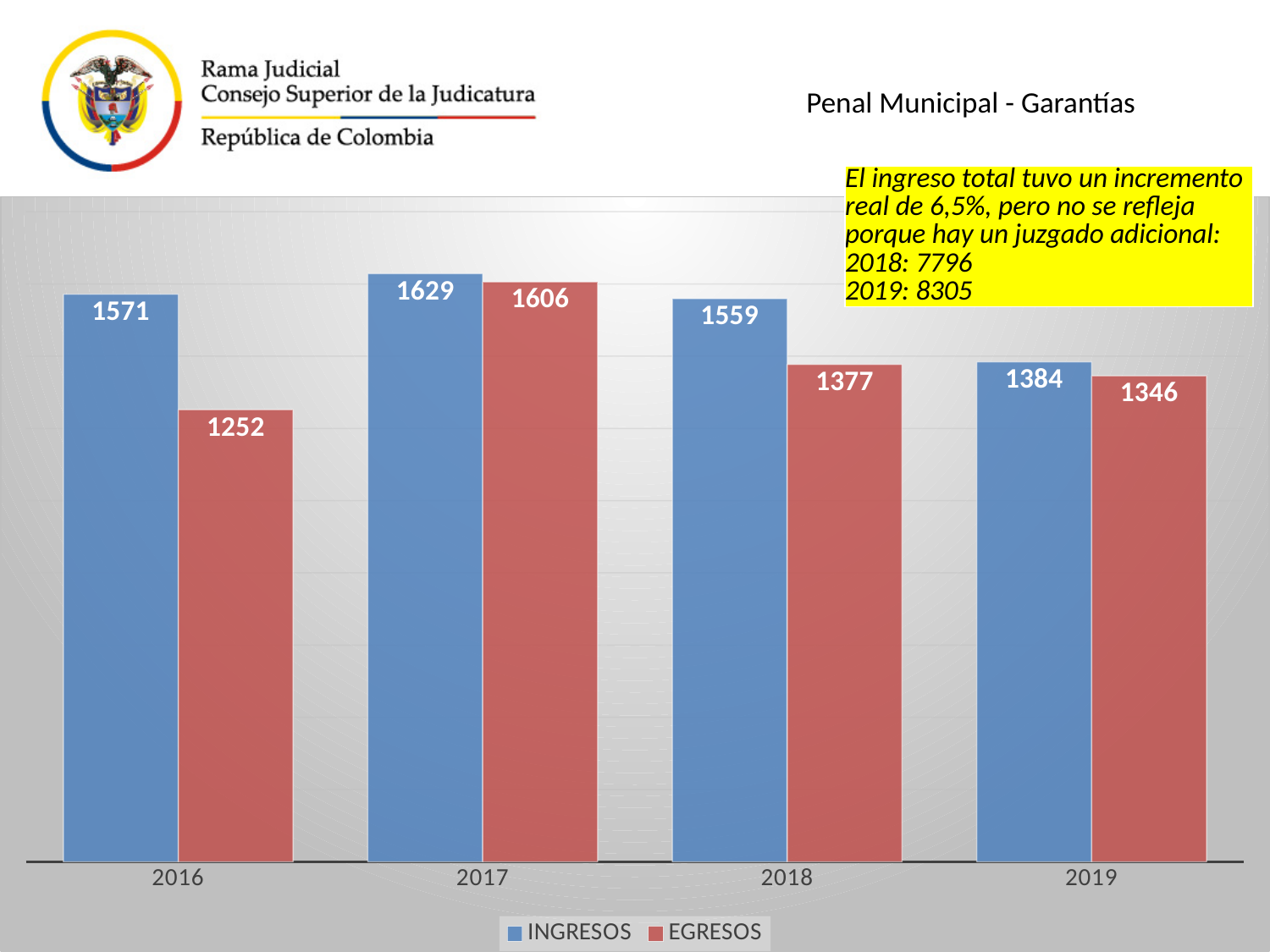
What is the EGRESOS value for 2019? 1346 What is the difference between INGRESOS in 2018 and INGRESOS in 2019? 175 What is the EGRESOS value for 2016? 1252 Which year has the highest INGRESOS value? 2017 Which colour represents EGRESOS in the chart? Red Which is larger in 2018, INGRESOS or EGRESOS? INGRESOS Which year has the lowest EGRESOS value? 2016 How many series does the legend list? 2 What is the INGRESOS value for 2017? 1629 How many years are shown on the x axis? 4 What kind of chart is shown on the slide? Bar chart What is the difference between INGRESOS and EGRESOS in 2016? 319